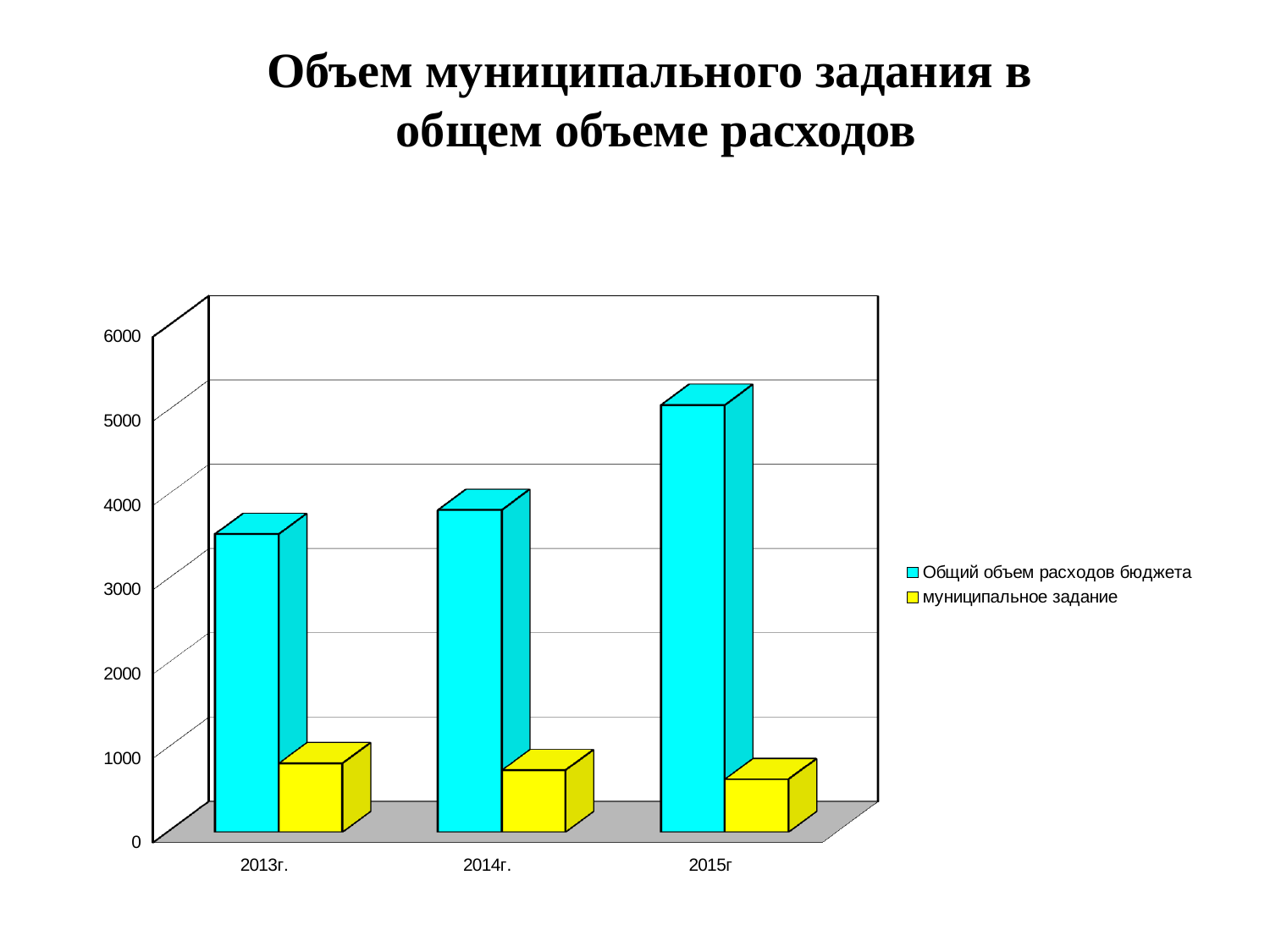
Is the value for Общий объем расходов бюджета in 2013г. greater or less than 3000? greater How many years are shown on the x axis? 3 What kind of chart is shown on the slide? bar chart How many series does the legend list? 2 Is the value for Общий объем расходов бюджета in 2015г greater or less than 4000? greater Which year has the lowest value for муниципальное задание? 2015г What colour are the bars for муниципальное задание? yellow In 2014г., which is larger: Общий объем расходов бюджета or муниципальное задание? Общий объем расходов бюджета Which year has the lowest value for Общий объем расходов бюджета? 2013г. Is the value for муниципальное задание in 2015г greater or less than 1000? less Do the values for Общий объем расходов бюджета rise or fall from 2013г. to 2015г? rise Which year has the highest value for Общий объем расходов бюджета? 2015г